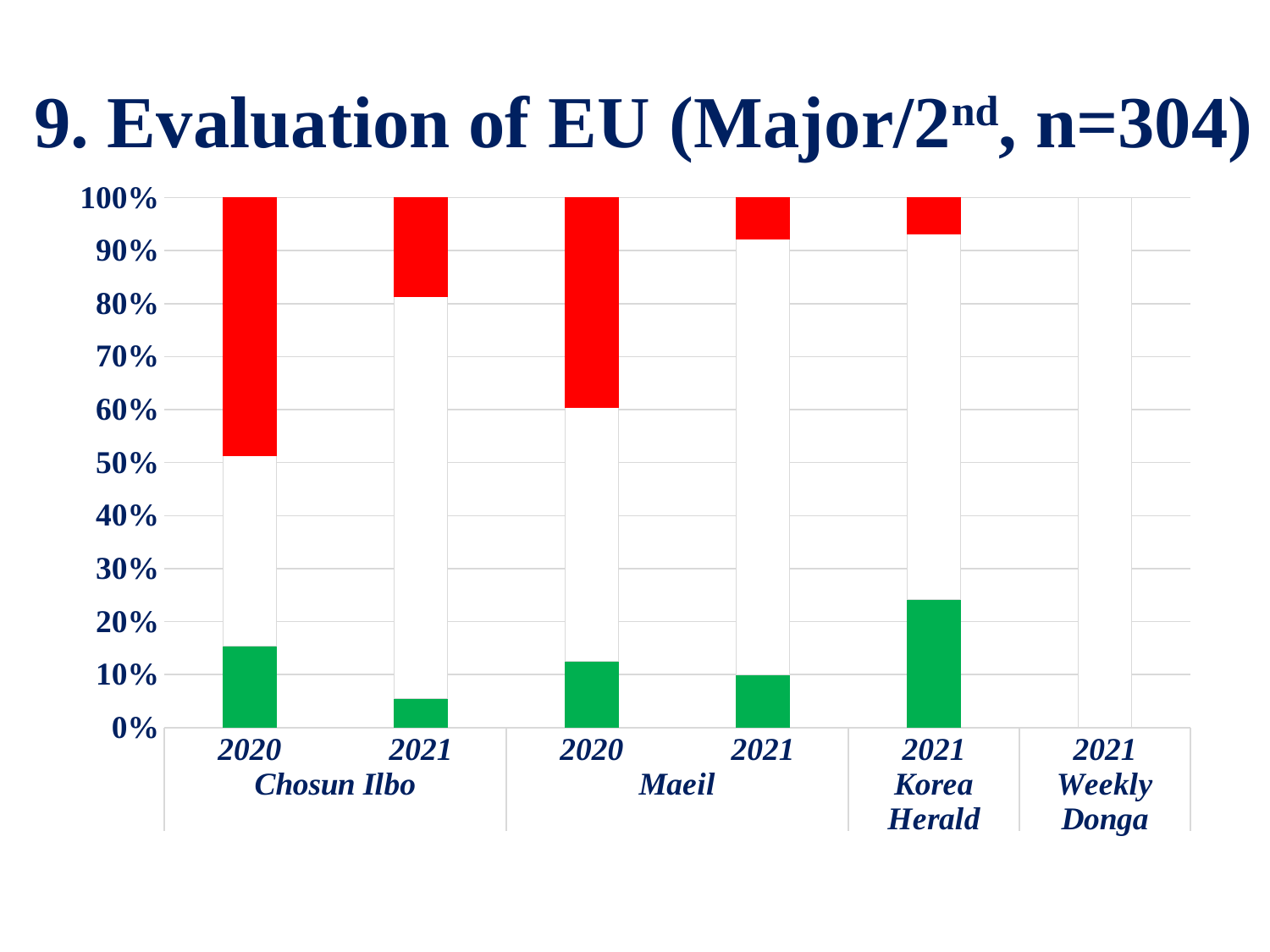
What kind of chart is shown on the slide? Stacked bar chart Is the green segment for Korea Herald 2021 greater or less than 20%? greater What is the title of the chart on the slide? 9. Evaluation of EU (Major/2nd, n=304) Which x-axis category has no bar plotted? Weekly Donga 2021 For Chosun Ilbo, does the red segment rise or fall from 2020 to 2021? fall How many newspapers are listed along the x axis? 4 Is the green segment for Chosun Ilbo 2020 greater or less than 10%? greater Which bar has the largest green segment? Korea Herald 2021 Among the bars that are plotted, which has the smallest green segment? Chosun Ilbo 2021 Is the red segment for Maeil 2020 greater or less than 30%? greater How many year categories are labelled along the x axis? 6 Which bar has the largest red segment? Chosun Ilbo 2020